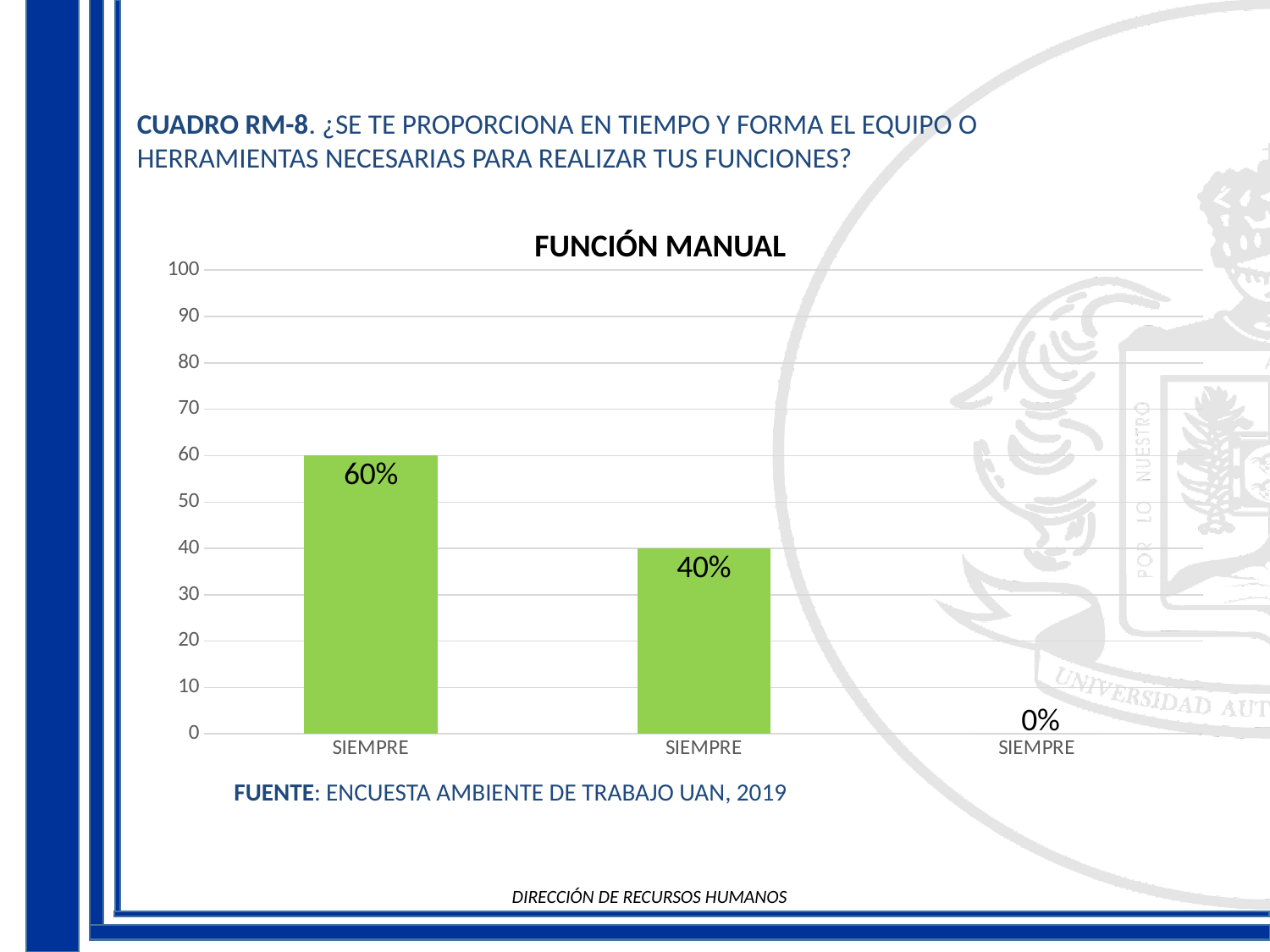
What is the highest value shown on the vertical axis of the chart? 100 How many bars (categories) are plotted in the chart? 3 What is the difference between the value of the left bar and the value of the middle bar? 20% What is the title of the chart? FUNCIÓN MANUAL Do the bar values rise or fall from left to right across the chart? fall Which is larger, the value of the left bar or the value of the middle bar? the left bar Which bar has the lowest value: the left, middle, or right one? right What is the value of the middle bar in the chart? 40% What is the value of the leftmost bar in the chart? 60% What type of chart is shown on the slide? bar chart What is the value of the rightmost bar in the chart? 0% Which bar has the highest value: the left, middle, or right one? left